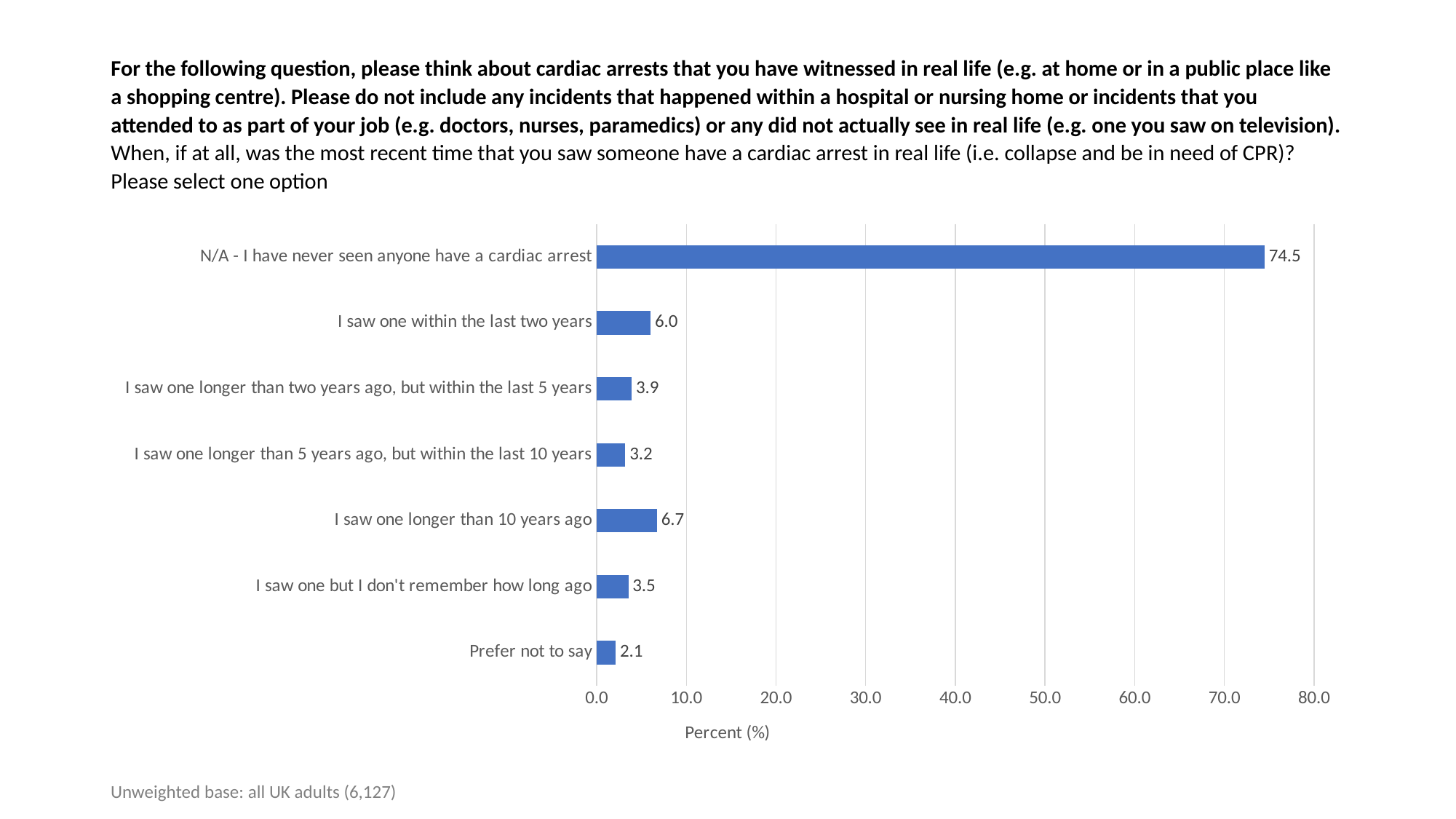
What is the value for "Prefer not to say"? 2.1 Which category has the lowest value? Prefer not to say What is the value for "I saw one longer than 10 years ago"? 6.7 What is the value for "N/A - I have never seen anyone have a cardiac arrest"? 74.5 Which is larger: the value for "I saw one longer than two years ago, but within the last 5 years" or "I saw one but I don't remember how long ago"? I saw one longer than two years ago, but within the last 5 years Is the value for "N/A - I have never seen anyone have a cardiac arrest" greater or less than 70.0? greater What is the difference between the values for "I saw one longer than 10 years ago" and "I saw one within the last two years"? 0.7 What kind of chart is shown on the slide? bar chart How many categories are shown in the chart? 7 Which category has the highest value? N/A - I have never seen anyone have a cardiac arrest What is the value for "I saw one within the last two years"? 6.0 What is the label of the horizontal axis? Percent (%)